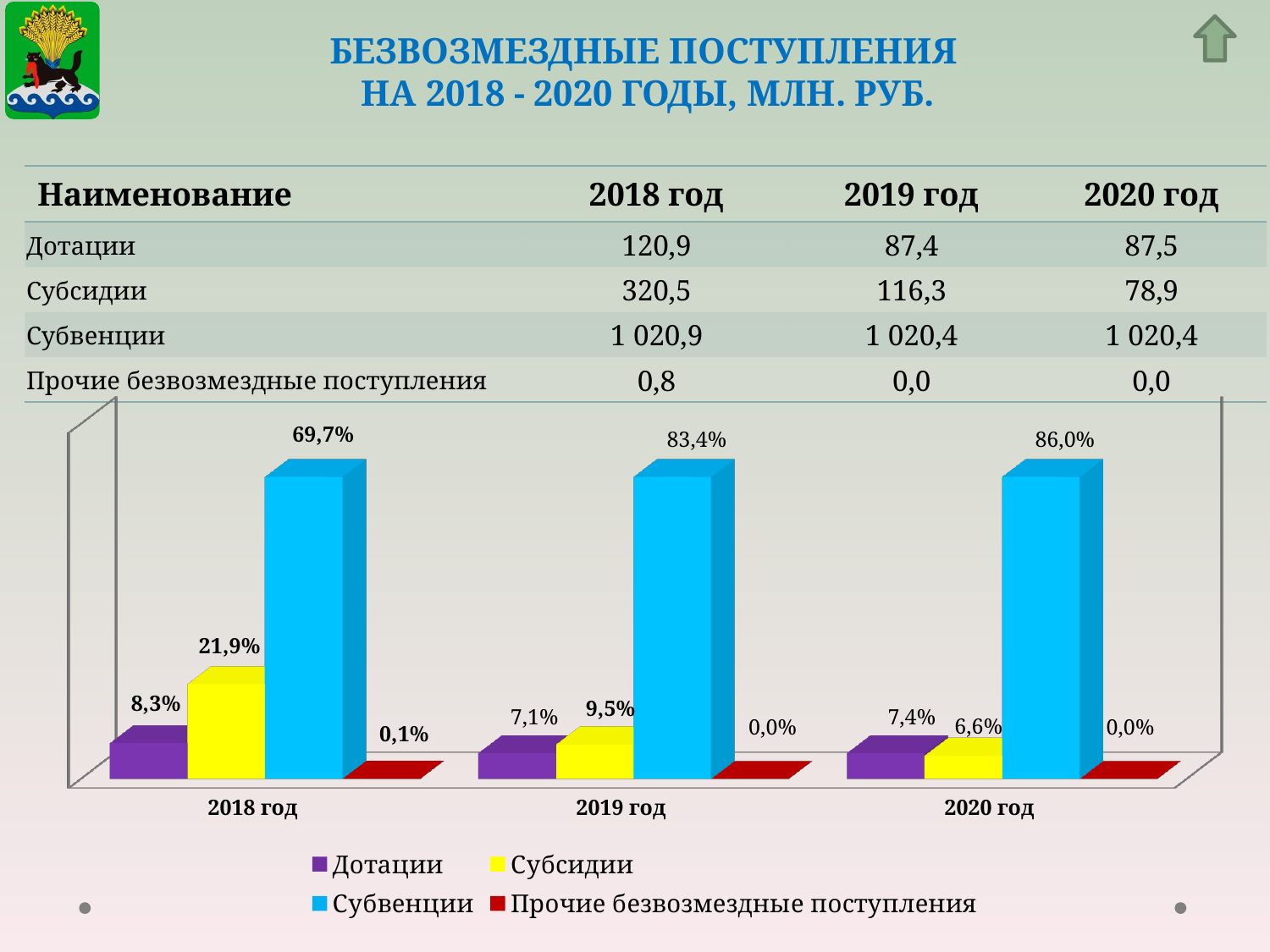
What is the value for Субвенции in 2018 год on the chart? 69,7% Does the value for Субвенции rise or fall from 2018 год to 2020 год on the chart? rise In which year is the value for Субвенции highest on the chart? 2020 год What is the difference between the Субвенции values for 2020 год and 2018 год on the chart? 16,3% What is the value for Субсидии in 2019 год on the chart? 9,5% What is the value for Дотации in 2020 год on the chart? 7,4% How many series does the chart legend list? 4 What is the value for Прочие безвозмездные поступления in 2018 год on the chart? 0,1% Which is larger on the chart: Дотации in 2018 год or Субсидии in 2018 год? Субсидии How many year categories are shown on the x axis of the chart? 3 In which year is the value for Субсидии lowest on the chart? 2020 год What kind of chart is shown on the slide? bar chart